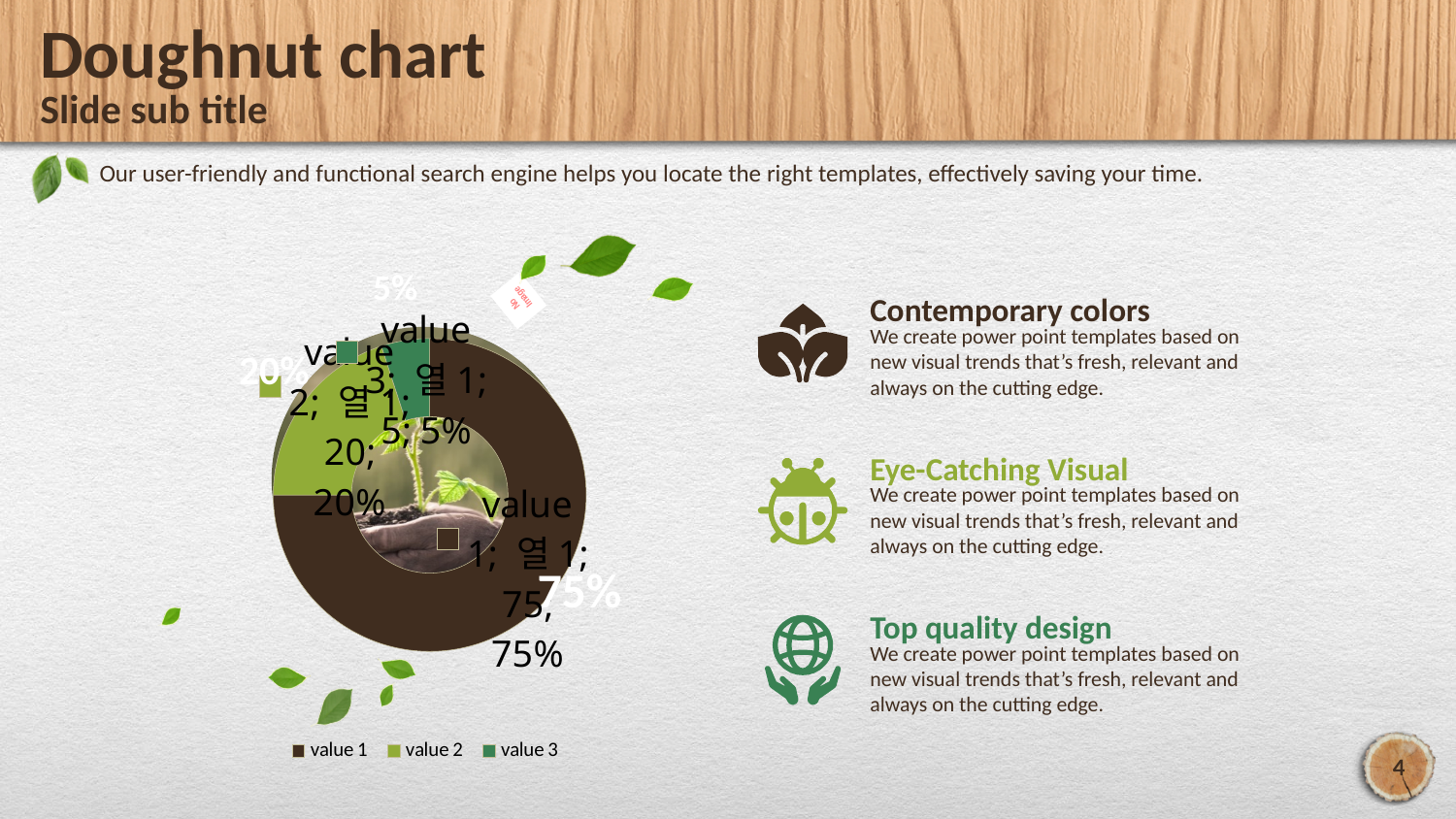
What percentage share does value 3 have in the doughnut chart? 5% What kind of chart is shown on the slide? doughnut chart What is the data value for value 2 in the doughnut chart? 20 What is the difference between the values of value 1 and value 2? 55 Which category has the largest slice in the doughnut chart? value 1 What percentage share does value 1 have in the doughnut chart? 75% Which is larger, value 2 or value 3? value 2 What are the legend entries of the chart? value 1, value 2, value 3 What percentage share does value 2 have in the doughnut chart? 20% How many entries does the chart legend list? 3 What is the data value for value 1 in the doughnut chart? 75 Which category has the smallest slice in the doughnut chart? value 3